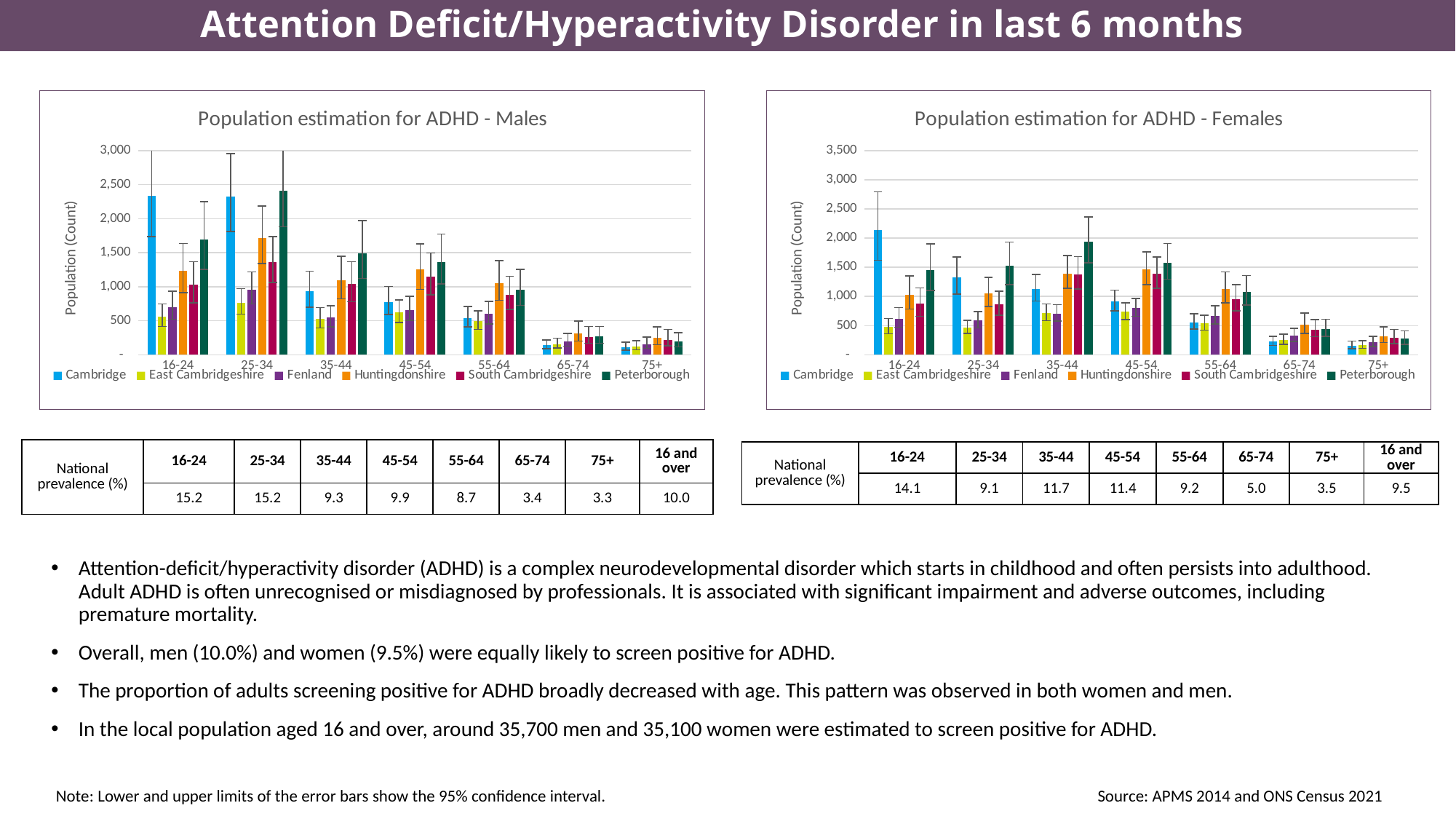
What is the y-axis label of the 'Population estimation for ADHD - Females' chart? Population (Count) In the 'Population estimation for ADHD - Males' chart, is the value for Cambridge in the 16-24 age group greater or less than 2,000? greater In the 'Population estimation for ADHD - Females' chart, which area has the lowest value in the 16-24 age group? East Cambridgeshire In the 'Population estimation for ADHD - Males' chart, which area has the highest value in the 16-24 age group? Cambridge In the 'Population estimation for ADHD - Males' chart, is the value for Cambridge in the 35-44 age group greater or less than 1,000? less How many series does the legend of the 'Population estimation for ADHD - Females' chart list? 6 What kind of chart is 'Population estimation for ADHD - Males'? bar chart In the 'Population estimation for ADHD - Females' chart, which is larger in the 35-44 age group: Peterborough or Fenland? Peterborough In the 'Population estimation for ADHD - Males' chart, do the Cambridge bars generally rise or fall from the 16-24 age group to the 75+ age group? fall In the 'Population estimation for ADHD - Females' chart, is the value for Peterborough in the 35-44 age group greater or less than 1,500? greater How many age groups are shown on the x axis of the 'Population estimation for ADHD - Males' chart? 7